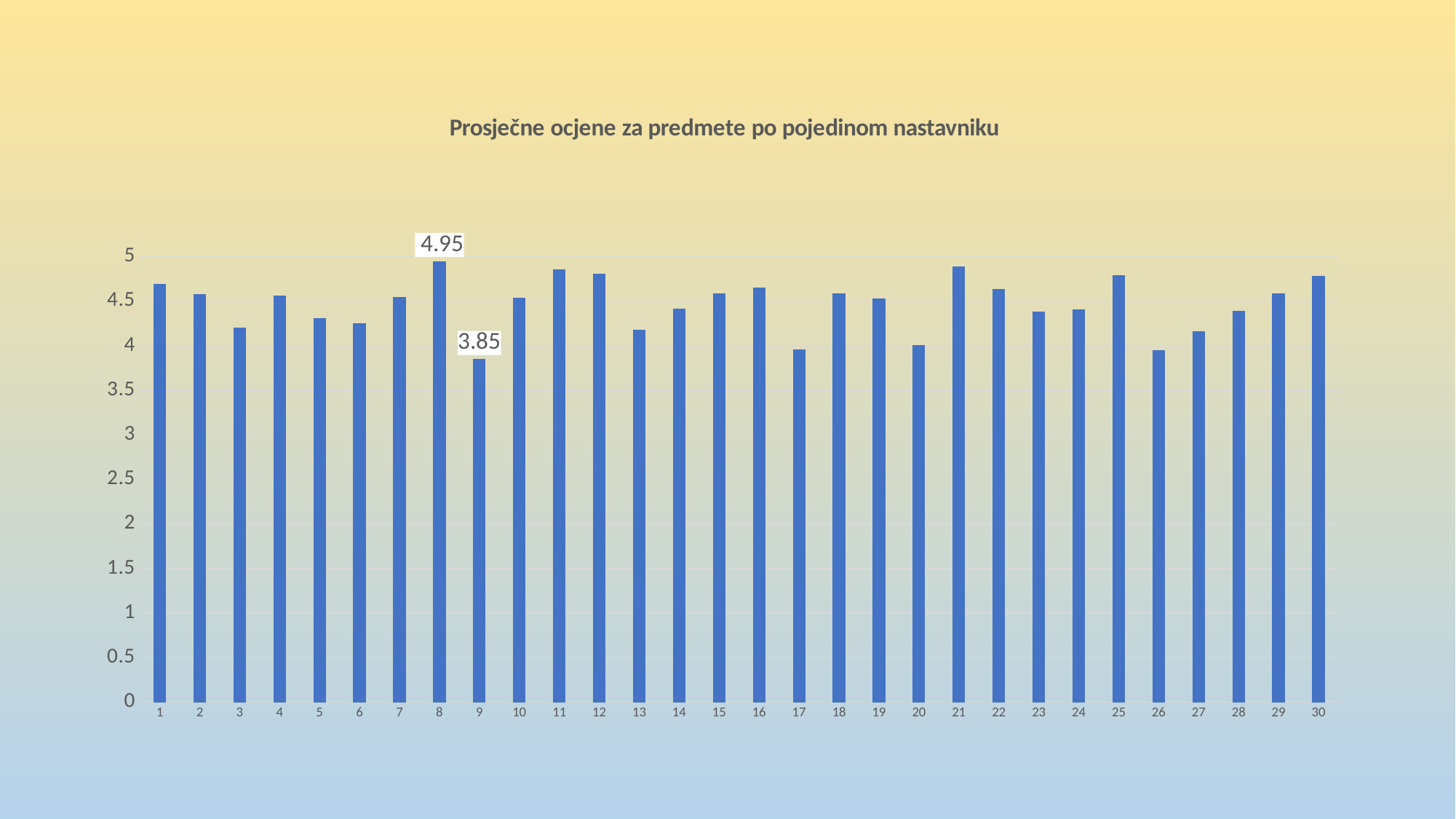
What is the title of the chart? Prosječne ocjene za predmete po pojedinom nastavniku What is the value for category 8? 4.95 What is the difference between the values for category 8 and category 9? 1.1 What is the value for category 9? 3.85 Is the value for category 3 greater or less than 4.5? less Which is larger, the value for category 11 or the value for category 3? 11 Which category has the highest value? 8 Is the value for category 9 greater or less than 4? less How many categories (teachers) are shown on the x axis? 30 Is the value for category 21 greater or less than 4.5? greater What type of chart is shown on the slide? bar chart Which category has the lowest value? 9